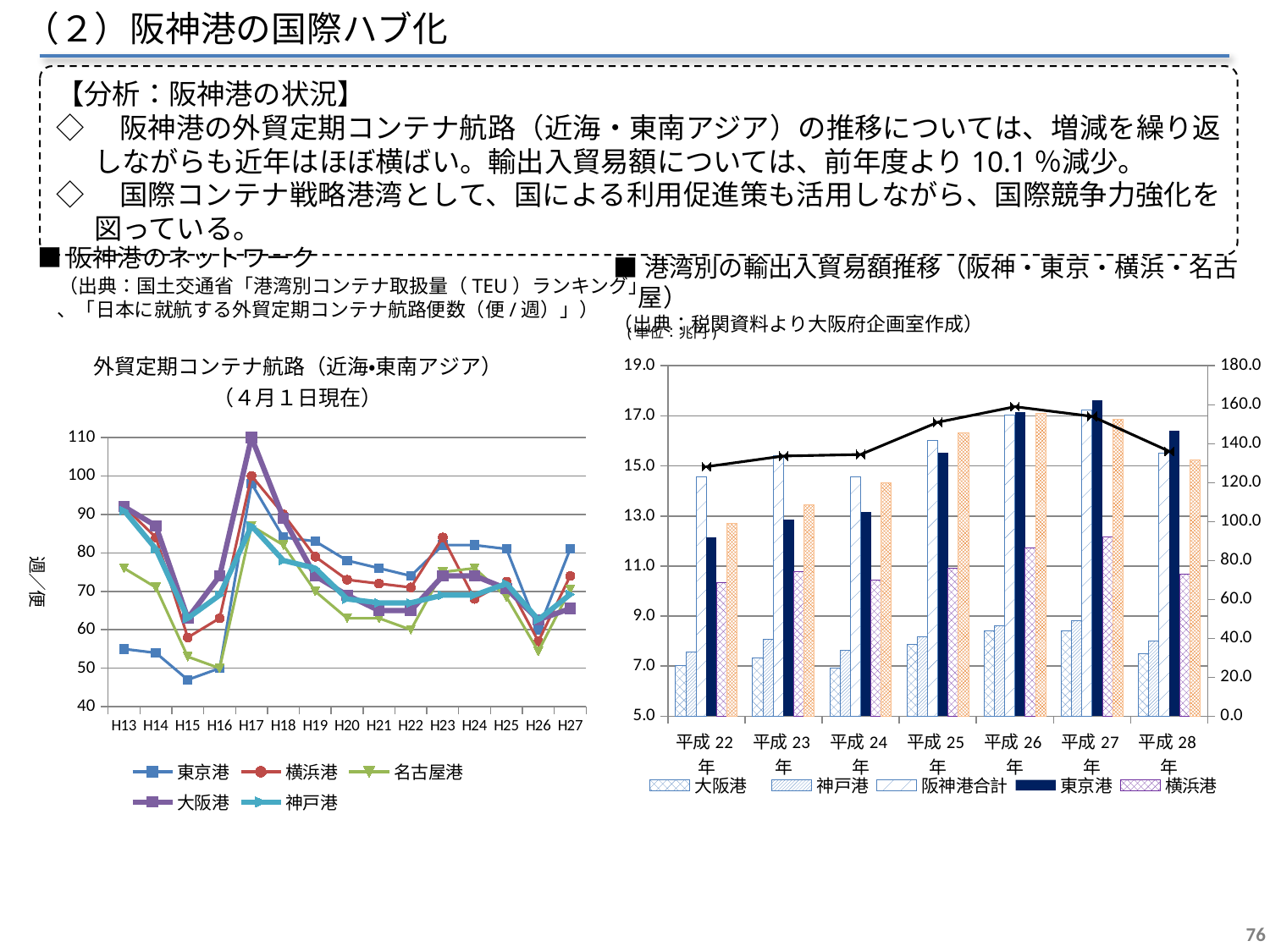
How many points are on the x axis of the left chart (外貿定期コンテナ航路), from H13 to H27? 15 How many series does the legend of the left chart (外貿定期コンテナ航路) list? 5 How many year categories are on the x axis of the right chart (港湾別の輸出入貿易額推移)? 7 In the left chart (外貿定期コンテナ航路), is the value for 名古屋港 at H26 greater or less than 60? less In the left chart (外貿定期コンテナ航路), is the value for 東京港 at H15 greater or less than 50? less In the left chart (外貿定期コンテナ航路), which port has the highest value at H17? 大阪港 In the left chart (外貿定期コンテナ航路), is the value for 大阪港 at H17 greater or less than 100? greater In the left chart (外貿定期コンテナ航路), does the value for 大阪港 rise or fall from H17 to H18? fall How many entries does the legend of the right chart (港湾別の輸出入貿易額推移) list? 5 What kind of chart is the left chart titled 外貿定期コンテナ航路（近海•東南アジア）? line chart